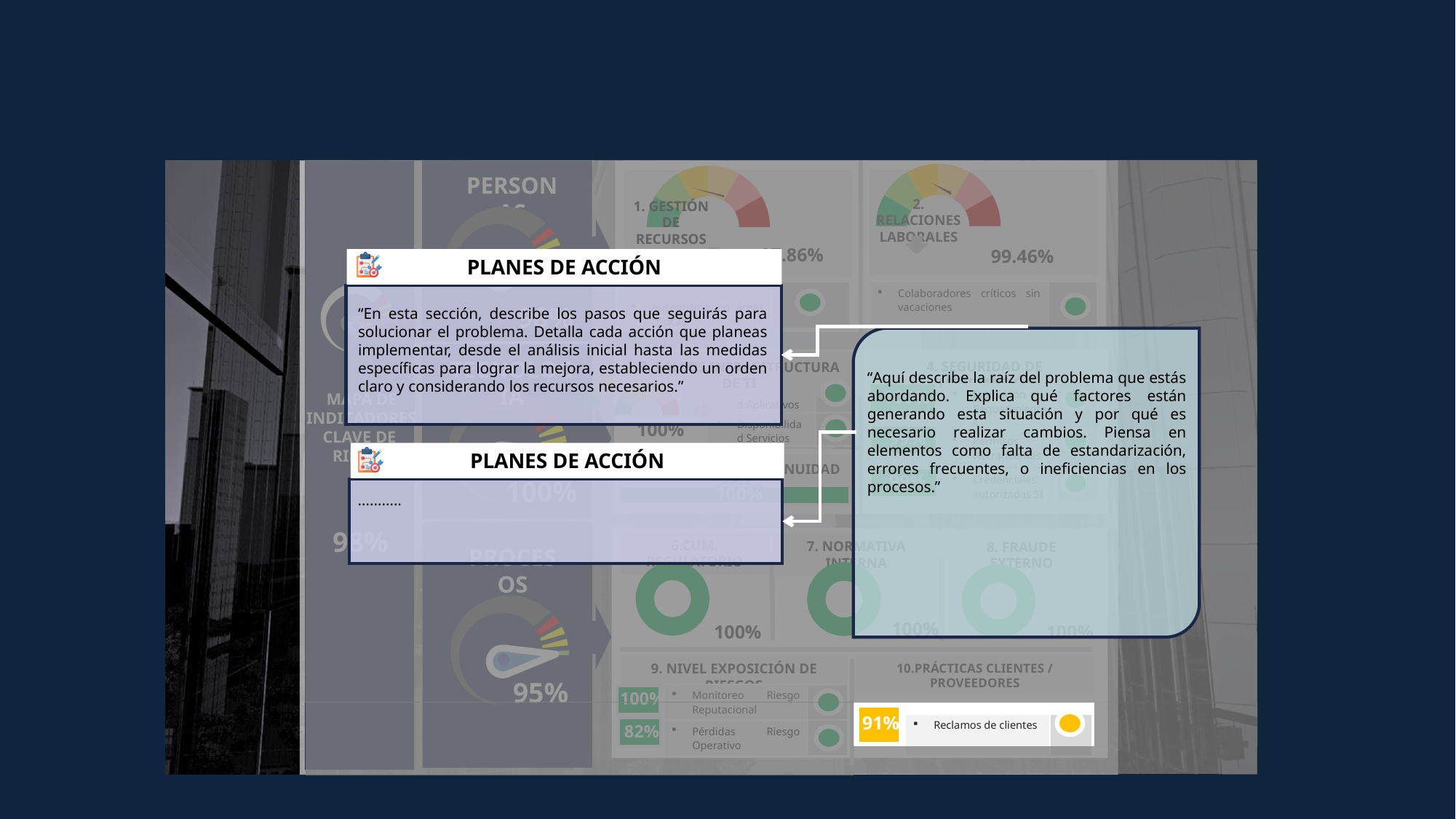
How many indicators are listed under '9. NIVEL EXPOSICIÓN DE RIESGOS'? 2 What kind of chart is used for '6. CUM. REGULATORIO'? Donut chart Under '9. NIVEL EXPOSICIÓN DE RIESGOS', which is larger: 'Monitoreo Riesgo Reputacional' or 'Pérdidas Riesgo Operativo'? Monitoreo Riesgo Reputacional What kind of chart is used for 'PROCESOS'? Gauge chart Under '9. NIVEL EXPOSICIÓN DE RIESGOS', what is the difference between 'Monitoreo Riesgo Reputacional' and 'Pérdidas Riesgo Operativo'? 18% What value is shown below the 'PROCESOS' gauge? 95% Under '10. PRÁCTICAS CLIENTES / PROVEEDORES', what value is shown for 'Reclamos de clientes'? 91% Under '9. NIVEL EXPOSICIÓN DE RIESGOS', what value is shown for 'Monitoreo Riesgo Reputacional'? 100% What colour is the value box for 'Reclamos de clientes' under '10. PRÁCTICAS CLIENTES / PROVEEDORES'? Yellow Under '9. NIVEL EXPOSICIÓN DE RIESGOS', what value is shown for 'Pérdidas Riesgo Operativo'? 82% What value is shown for the '6. CUM. REGULATORIO' donut chart? 100% What value is shown for the '2. RELACIONES LABORALES' gauge? 99.46%